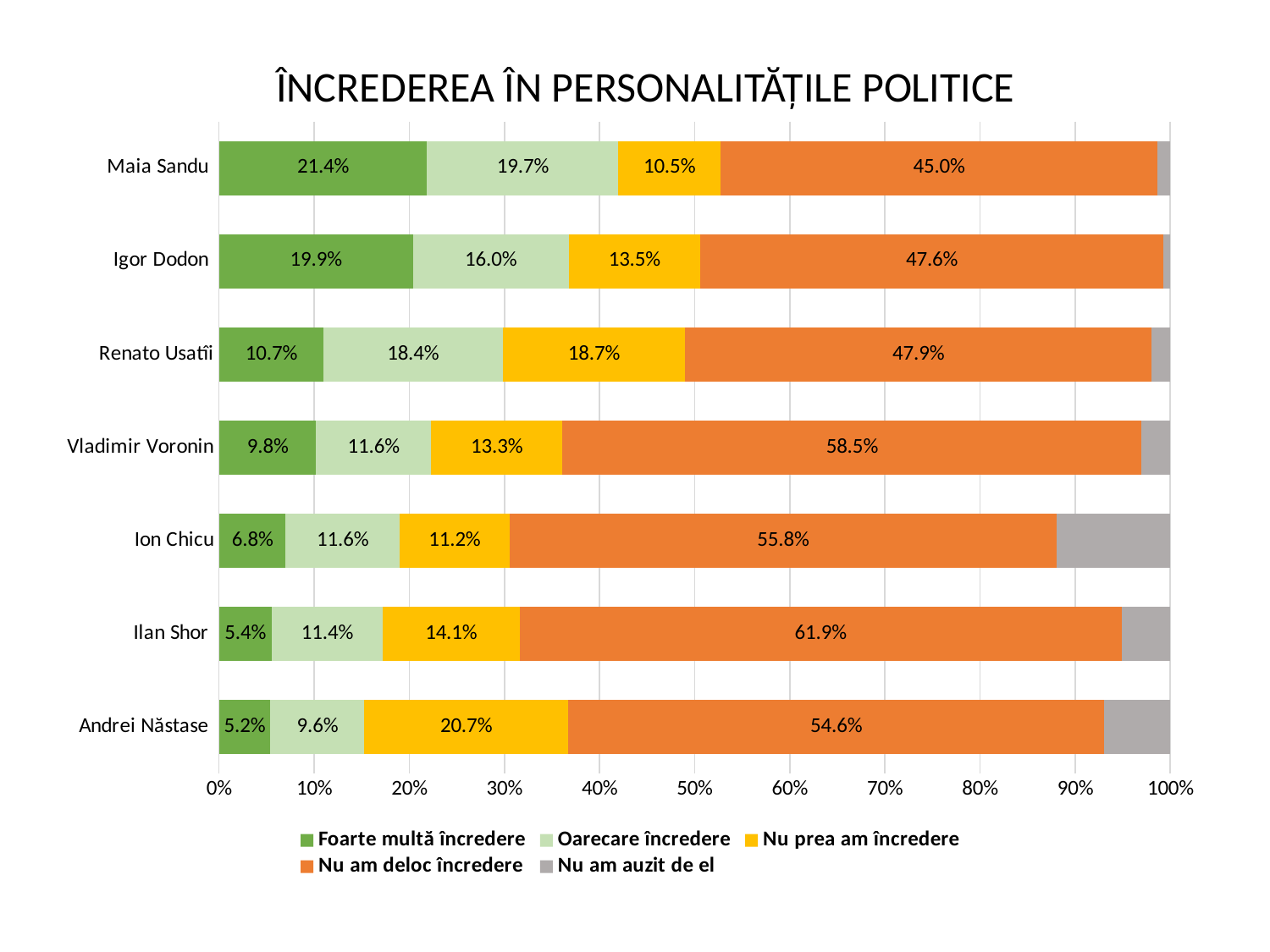
Which is larger, the 'Oarecare încredere' value for Igor Dodon or for Renato Usatîi? Renato Usatîi What is the difference between the 'Nu am deloc încredere' values for Ilan Shor and Maia Sandu? 16.9% Is the 'Nu am auzit de el' segment for Ion Chicu greater or less than 10%? greater What is the title of the chart? ÎNCREDEREA ÎN PERSONALITĂȚILE POLITICE How many series does the legend list? 5 What is the 'Foarte multă încredere' value for Maia Sandu? 21.4% What is the 'Nu am deloc încredere' value for Ilan Shor? 61.9% How many political figures are listed on the chart? 7 Which political figure has the lowest 'Nu am deloc încredere' value? Maia Sandu What is the 'Nu prea am încredere' value for Andrei Năstase? 20.7% Which political figure has the highest 'Foarte multă încredere' value? Maia Sandu What kind of chart is shown on the slide? stacked bar chart